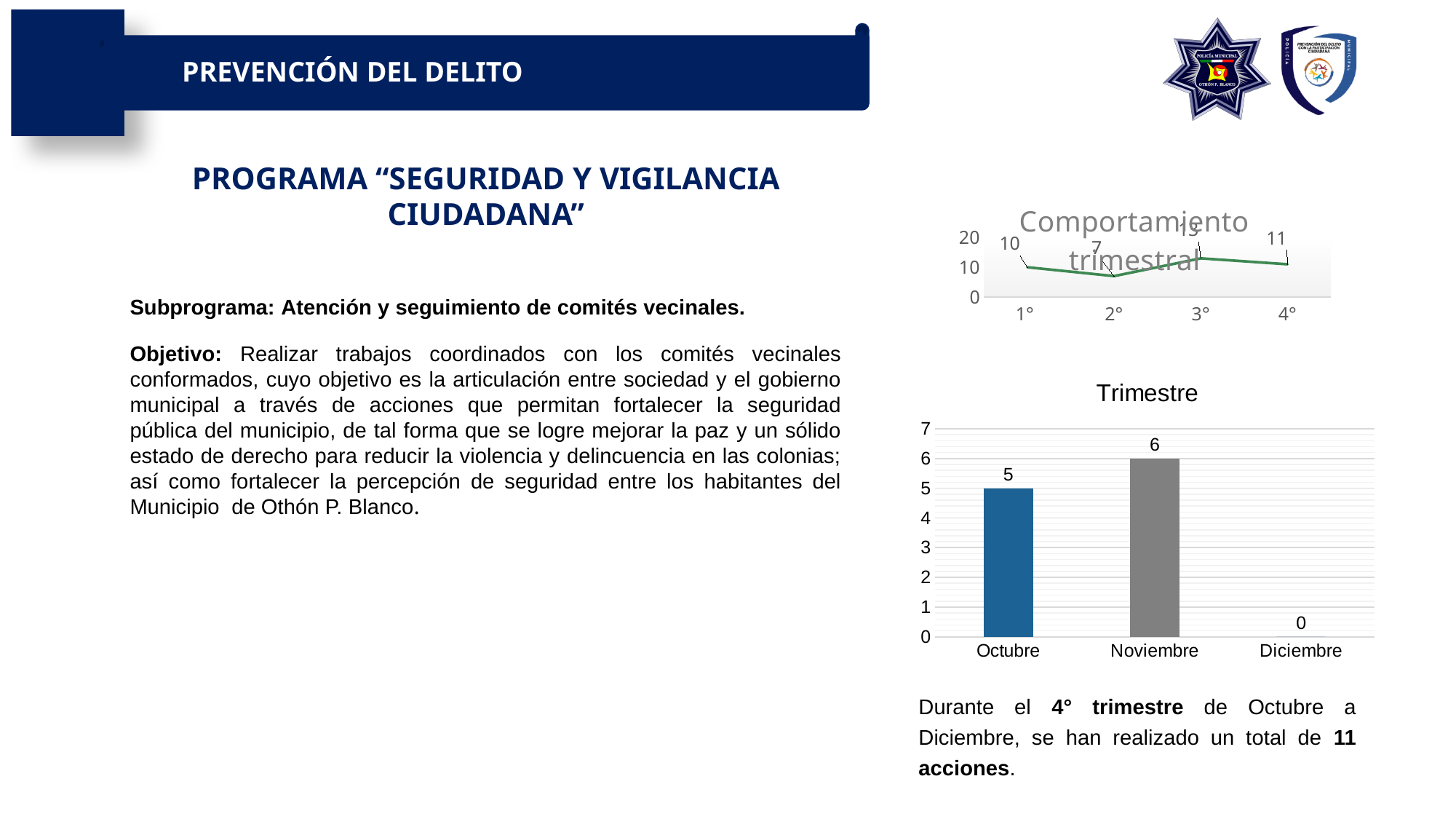
In the "Trimestre" chart, what is the value for Diciembre? 0 In the "Comportamiento trimestral" chart, what is the value for 4°? 11 In the "Comportamiento trimestral" chart, which is larger, the value for 1° or the value for 2°? 1° In the "Comportamiento trimestral" chart, what is the value for 1°? 10 In the "Trimestre" chart, what is the value for Noviembre? 6 What kind of chart is the "Comportamiento trimestral" chart? line chart In the "Trimestre" chart, how many months are shown on the x axis? 3 In the "Trimestre" chart, which month has the highest value? Noviembre In the "Trimestre" chart, what is the value for Octubre? 5 In the "Trimestre" chart, which month has the lowest value? Diciembre In the "Trimestre" chart, what is the difference between the values for Noviembre and Octubre? 1 What kind of chart is the "Trimestre" chart? bar chart